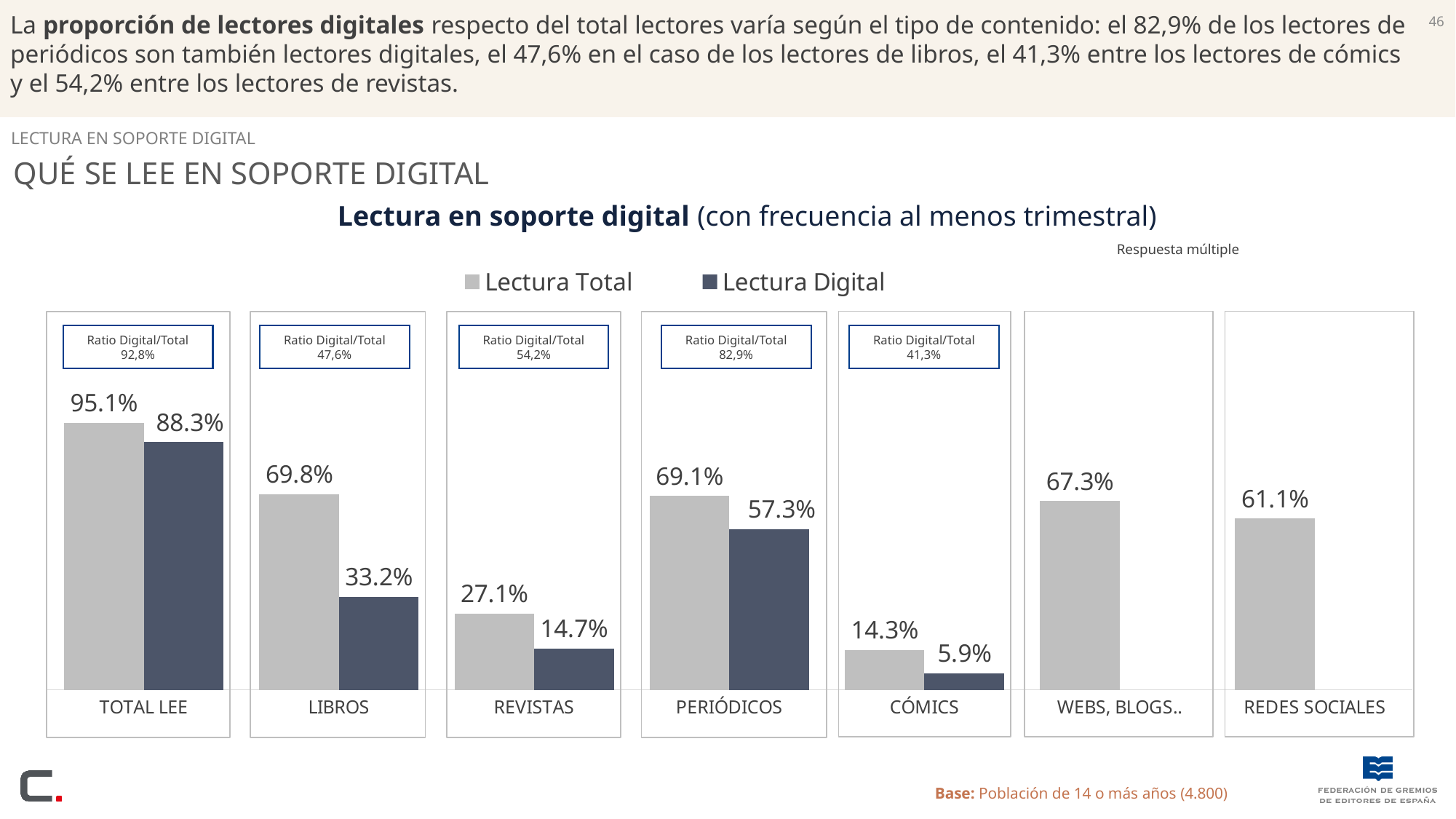
What is the Lectura Total value for LIBROS? 69.8% What is the Ratio Digital/Total shown for REVISTAS? 54,2% How many series does the legend list? 2 Which is larger: the Lectura Digital value for PERIÓDICOS or the Lectura Digital value for LIBROS? PERIÓDICOS Which category has the highest Lectura Digital value? TOTAL LEE What is the Lectura Digital value for PERIÓDICOS? 57.3% Which category has the lowest Lectura Total value? CÓMICS What is the Lectura Digital value for CÓMICS? 5.9% What is the difference between the Lectura Total and Lectura Digital values for LIBROS? 36.6 percentage points What value is shown for REDES SOCIALES? 61.1% How many categories are shown on the x axis of the chart? 7 What kind of chart is shown on the slide? Bar chart